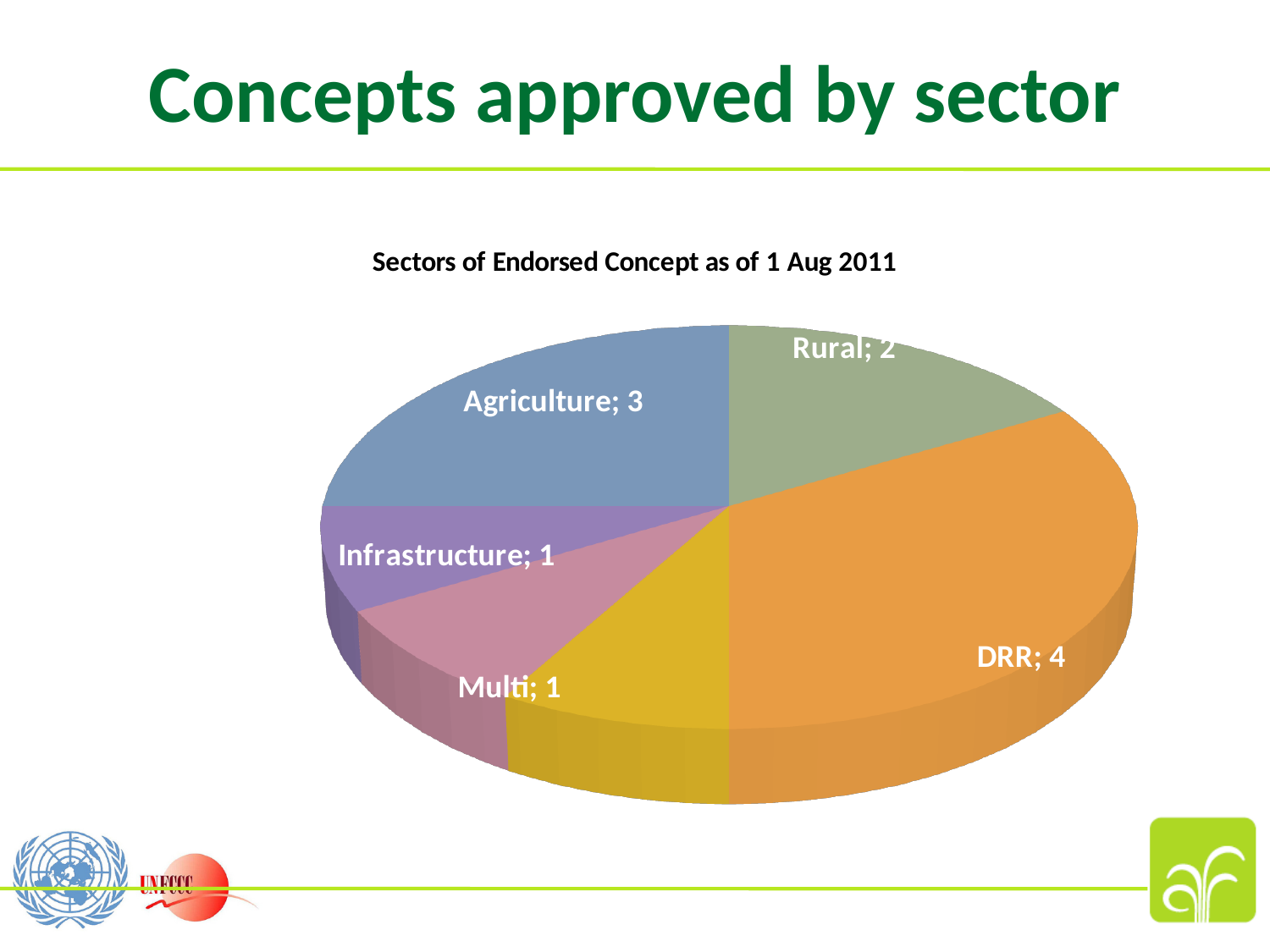
Which labelled sector has the largest slice in the pie chart? DRR What is the value for Agriculture in the pie chart? 3 What kind of chart is shown on the slide? Pie chart What is the title of the chart? Sectors of Endorsed Concept as of 1 Aug 2011 What is the difference between the values for DRR and Rural? 2 What is the value for Infrastructure in the pie chart? 1 What is the value for Multi in the pie chart? 1 What is the difference between the values for DRR and Agriculture? 1 Which is larger, the value for Agriculture or the value for Rural? Agriculture What colour is the DRR slice in the pie chart? Orange What is the value for Rural in the pie chart? 2 What is the value for DRR in the pie chart? 4